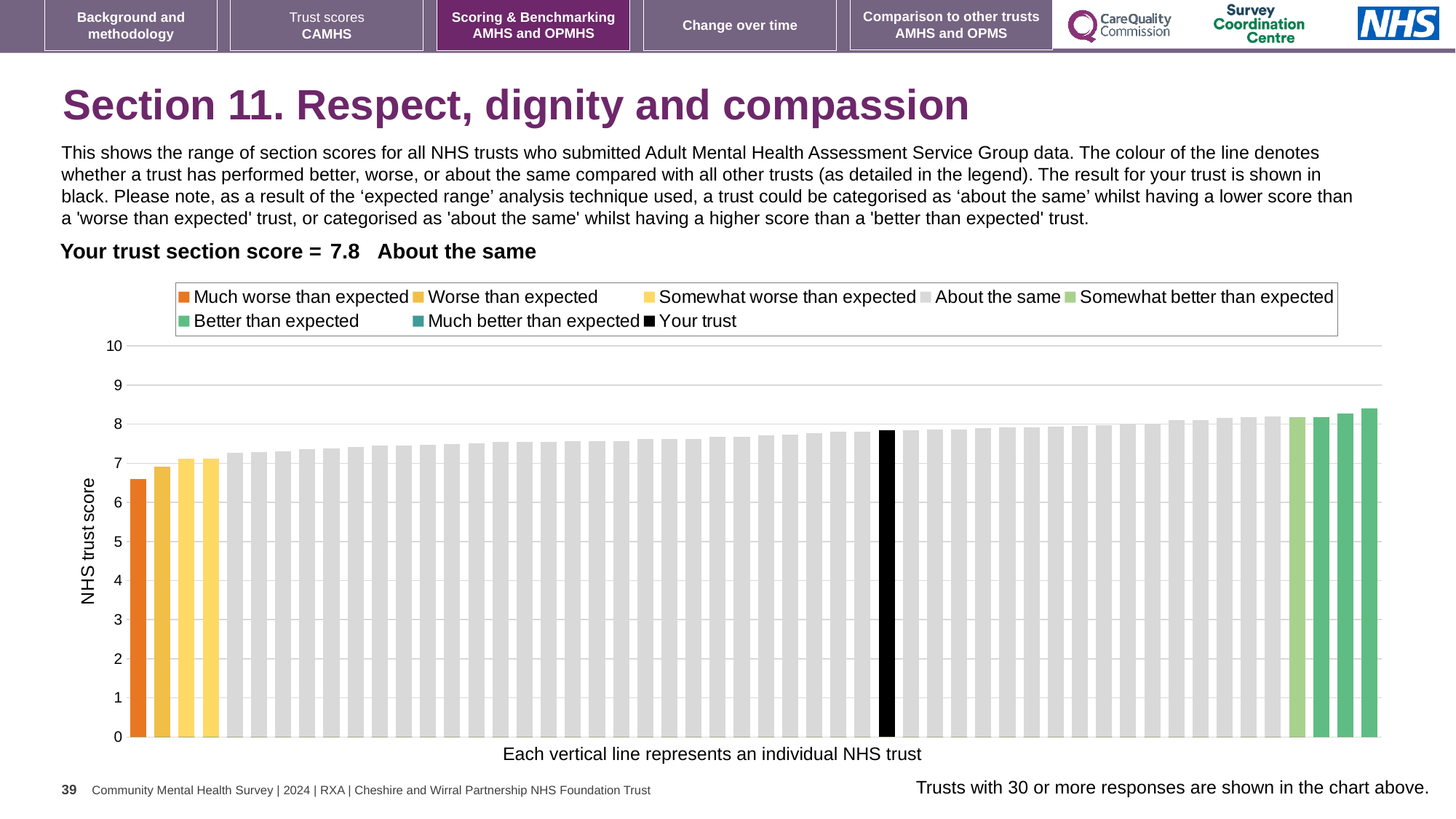
What is the section score for your trust shown on the slide? 7.8 Is the black 'Your trust' bar higher or lower than the orange 'Much worse than expected' bar? higher Do the bar values rise or fall from left to right along the x axis? rise Is the value of the black 'Your trust' bar greater or less than 7? greater Which legend category does the lowest bar in the chart belong to? Much worse than expected What kind of chart is shown on the slide? bar chart Is the value of the orange 'Much worse than expected' bar greater or less than 7? less Which legend category does the highest bar in the chart belong to? Better than expected Is the value of the tallest bar in the chart greater or less than 8? greater What is the label on the vertical axis of the chart? NHS trust score How many entries does the chart legend list? 8